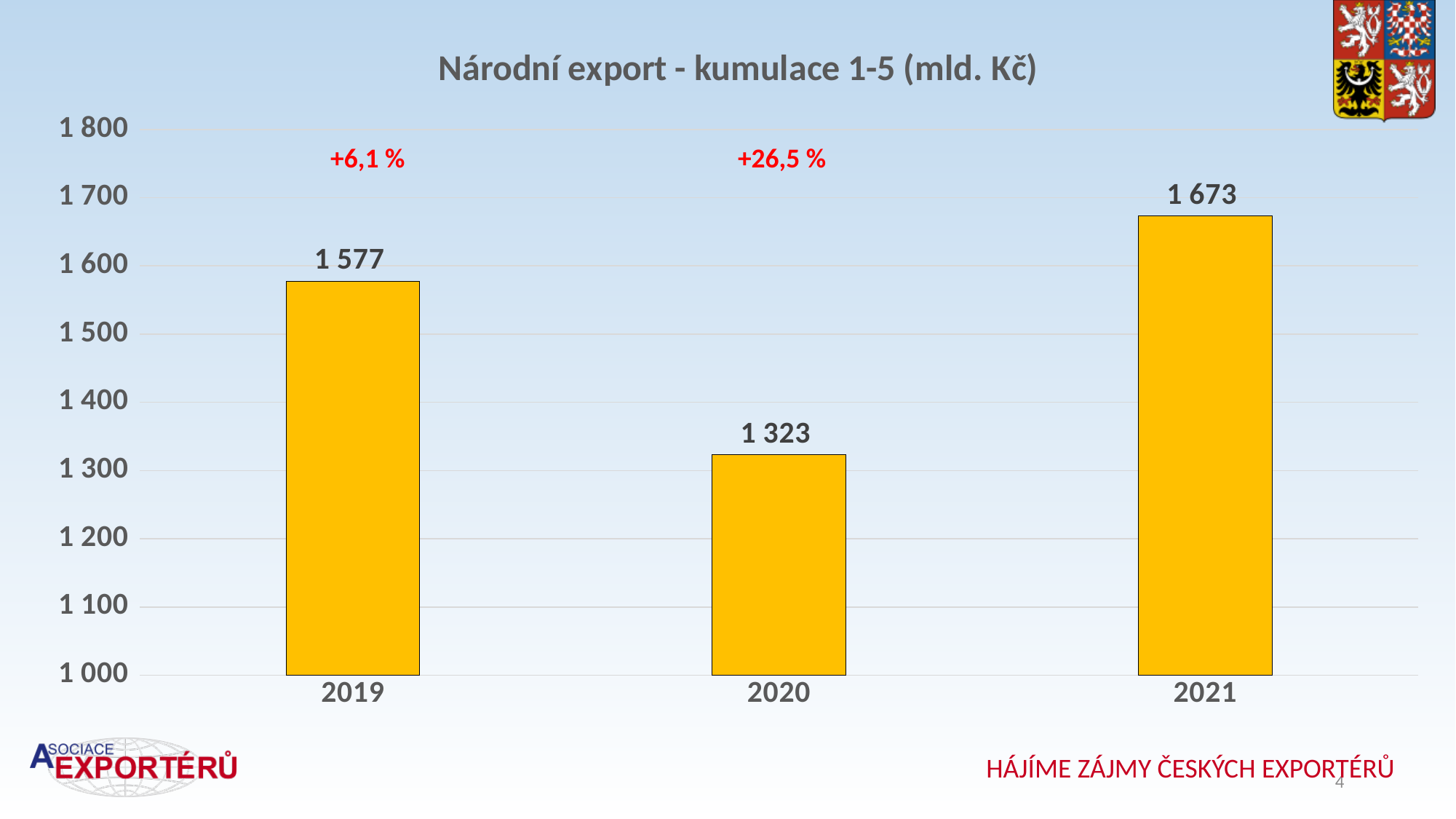
What is the value for 2019? 1 577 How many years are shown on the x axis? 3 What is the difference between the values for 2019 and 2020? 254 Which is larger, the value for 2019 or the value for 2021? 2021 Is the value for 2020 greater or less than 1 400? less Which year has the highest value? 2021 What is the title of the chart? Národní export - kumulace 1-5 (mld. Kč) What is the difference between the values for 2021 and 2020? 350 What is the value for 2020? 1 323 What is the value for 2021? 1 673 Which year has the lowest value? 2020 What kind of chart is shown on the slide? bar chart